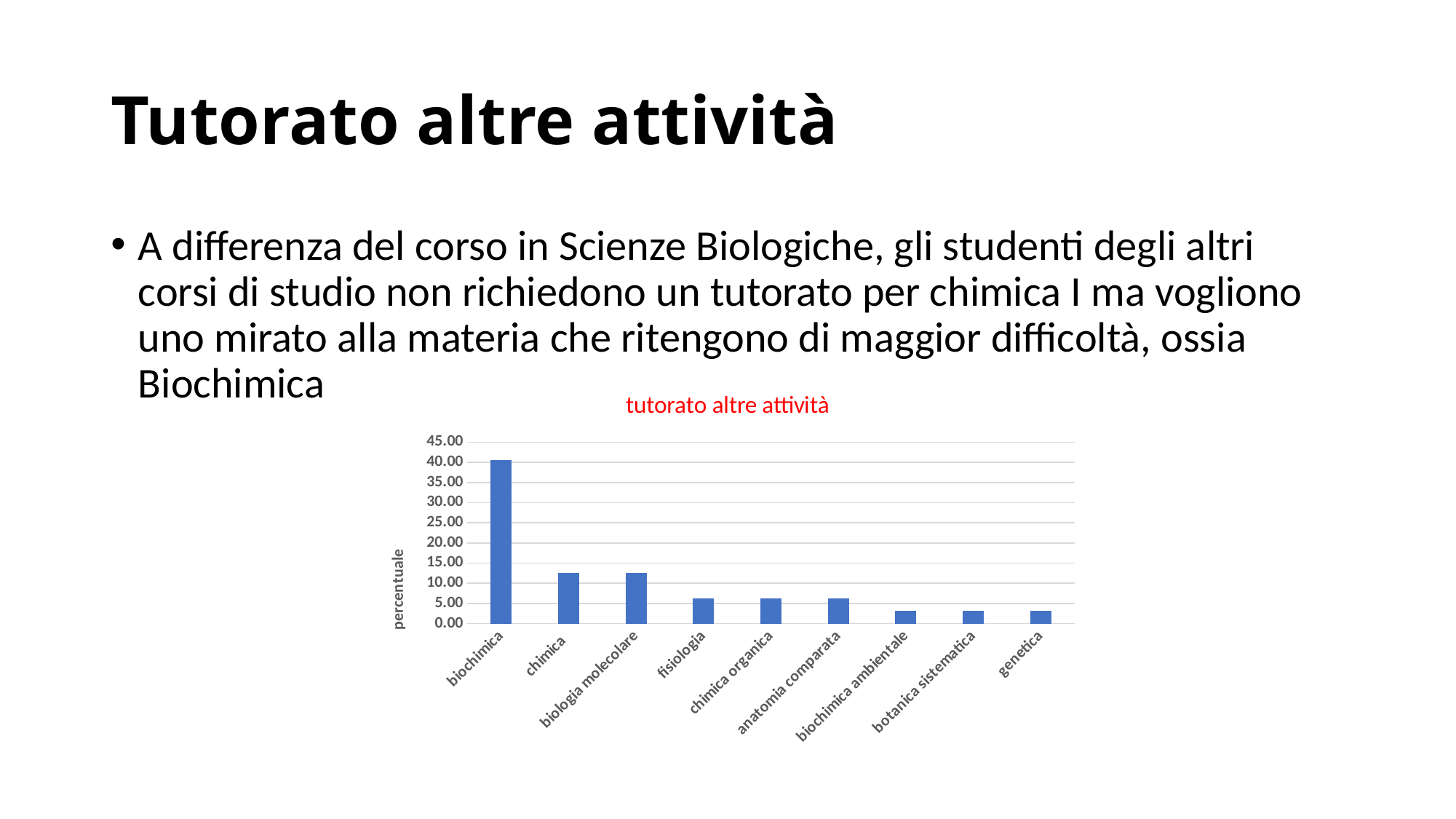
Is the value for fisiologia greater or less than 10.00? less How many categories are shown on the x axis of the chart? 9 What is the label on the vertical axis of the chart? percentuale Is the value for chimica greater or less than 10.00? greater Is the value for anatomia comparata greater or less than 5.00? greater What kind of chart is shown on the slide? bar chart Which category has the highest value in the chart? biochimica Do the values generally rise or fall from left to right along the x axis? fall What is the title of the chart? tutorato altre attività Which is larger, the value for biochimica or the value for chimica? biochimica